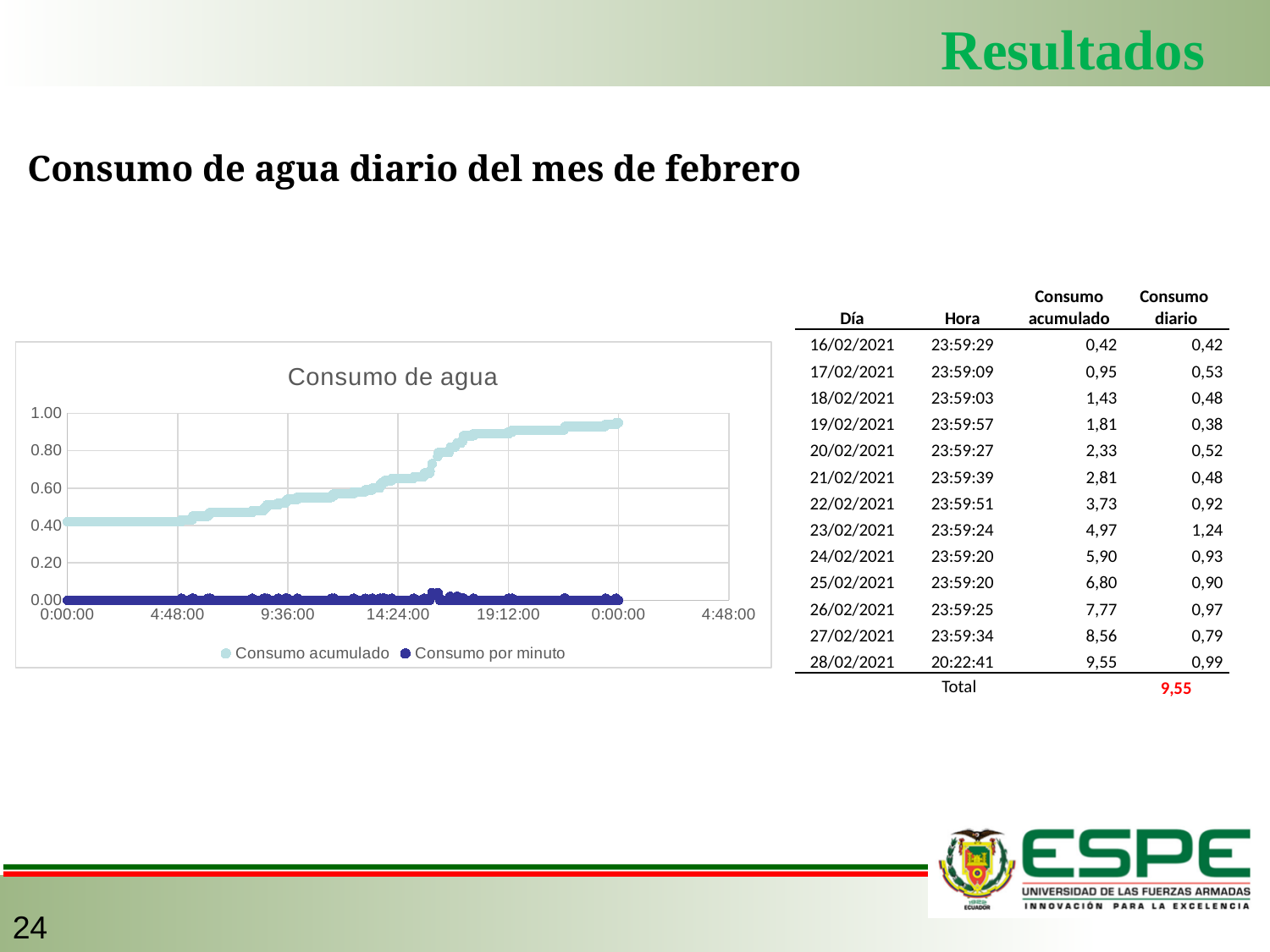
Does the Consumo acumulado series rise or fall along the x axis? rise How many tick labels are shown on the chart's x axis? 7 Is the value of Consumo por minuto at 9:36:00 greater or less than 0.20? less What are the two series named in the chart's legend? Consumo acumulado and Consumo por minuto Is the value of Consumo acumulado at 19:12:00 greater or less than 0.80? greater What is the title of the chart on the slide? Consumo de agua At 19:12:00, which series has the higher value, Consumo acumulado or Consumo por minuto? Consumo acumulado Is the value of Consumo acumulado at 9:36:00 greater or less than 0.60? less How many series does the chart's legend list? 2 What kind of chart is shown on the slide? scatter chart What is the highest value shown on the chart's y axis? 1.00